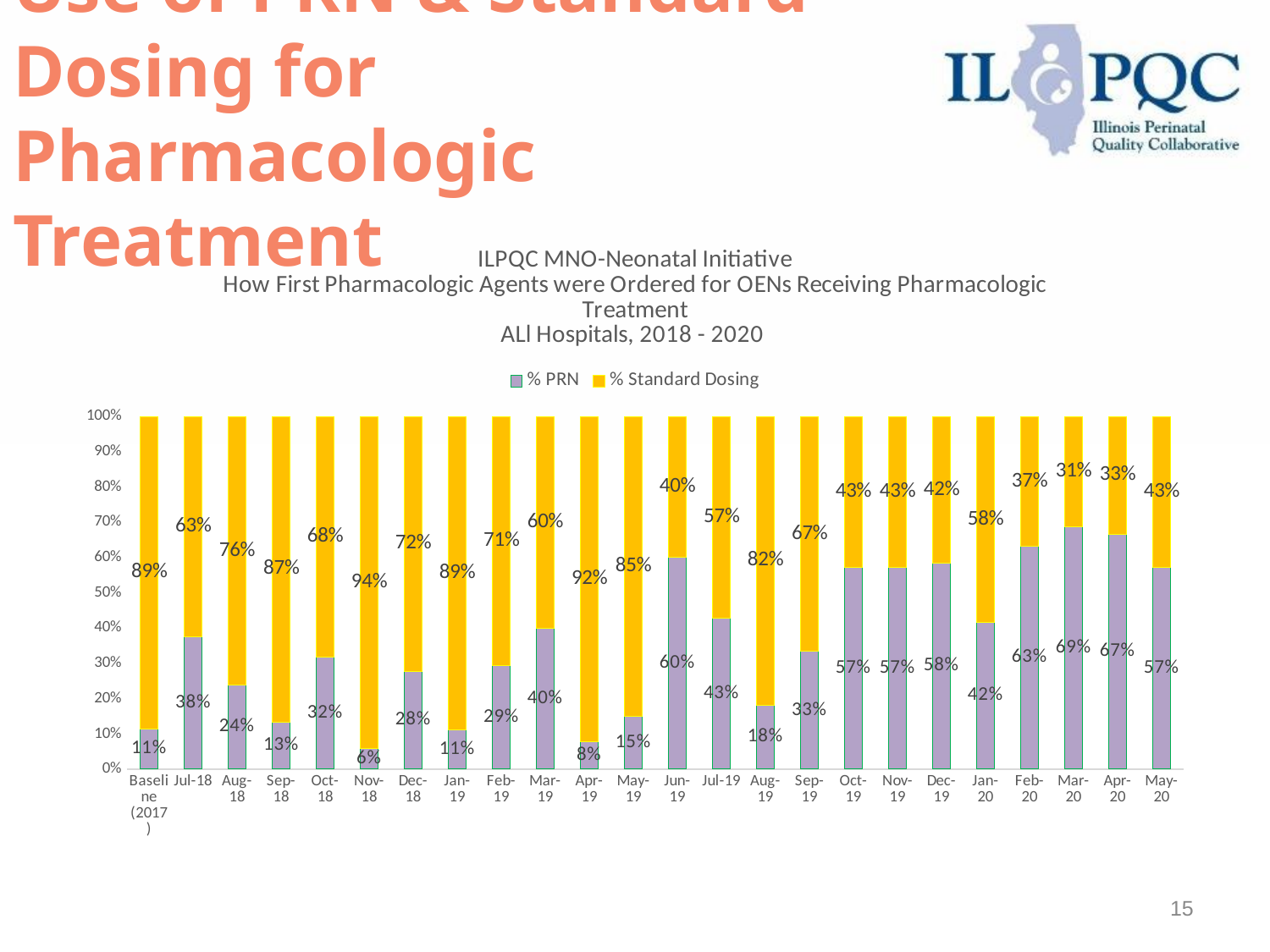
Which month has the highest % Standard Dosing value? Nov-18 Which month has the highest % PRN value? Mar-20 Which colour represents % Standard Dosing in the chart? Yellow What kind of chart is shown on the slide? Stacked bar chart How many time-period categories are shown on the x axis? 24 Which is larger, the % PRN value for Jul-18 or for Aug-18? Jul-18 Which month has the lowest % Standard Dosing value? Mar-20 How many series does the legend list? 2 What is the % PRN value for the Baseline (2017) bar? 11% What is the % Standard Dosing value for Jun-19? 40% What is the % PRN value for Nov-18? 6% What is the difference between the % PRN values for Mar-20 and Jan-20? 27%